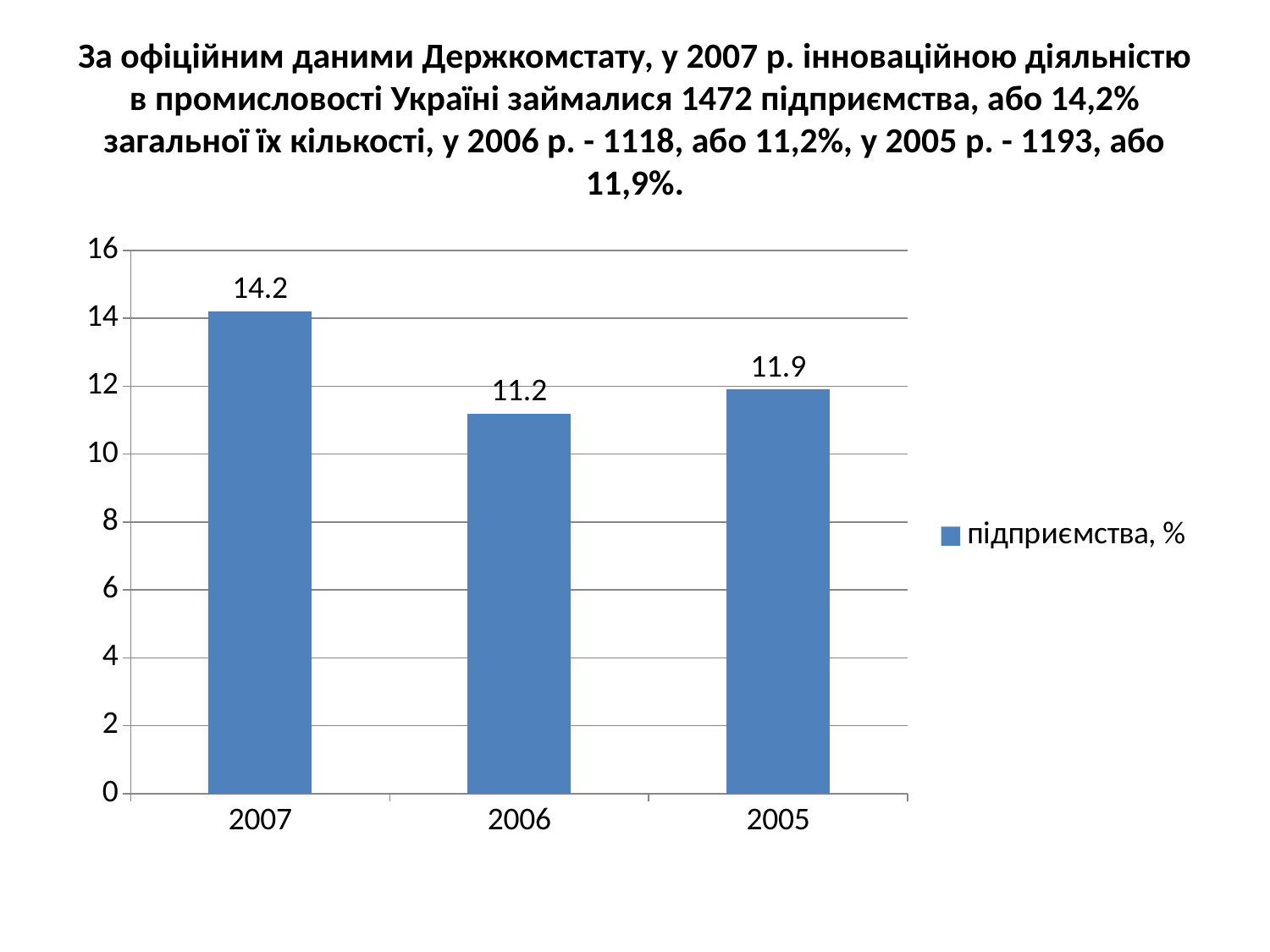
What is the difference between the values for 2005 and 2006? 0.7 How many bars are shown in the chart? 3 What kind of chart is shown on the slide? bar chart What series name does the legend show? підприємства, % What is the value for 2007? 14.2 What is the value for 2006? 11.2 Which year has the highest value? 2007 What is the difference between the values for 2007 and 2006? 3 What is the value for 2005? 11.9 Is the value for 2007 greater or less than 12? greater Which is larger, the value for 2005 or the value for 2006? 2005 Which year has the lowest value? 2006